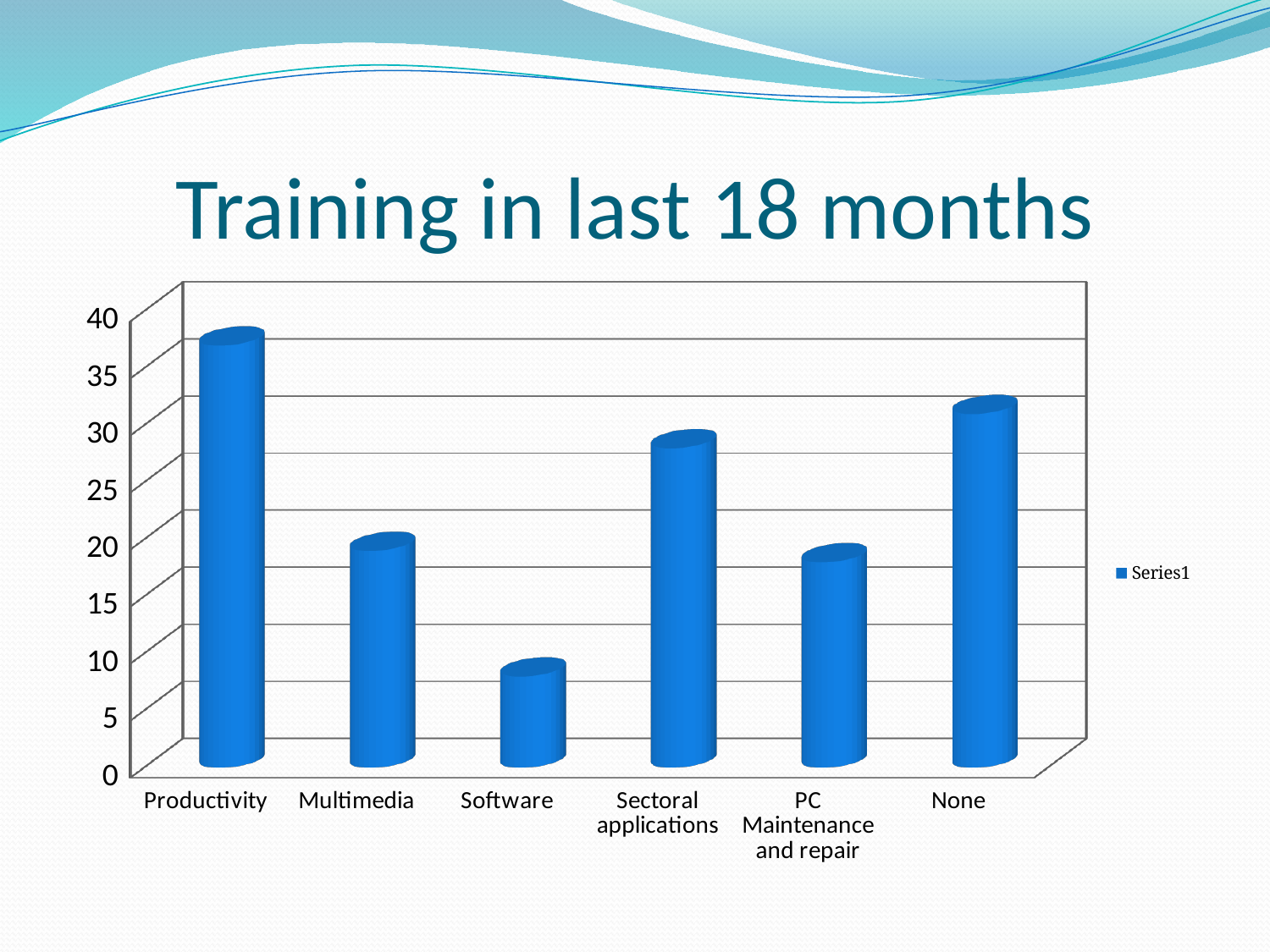
Is the value for Sectoral applications greater or less than 25? greater How many series does the legend list? 1 Which category has the highest value? Productivity Which is larger, the value for Multimedia or the value for Software? Multimedia What is the title of the chart? Training in last 18 months Which category has the lowest value? Software Is the value for Productivity greater or less than 35? greater How many categories are shown on the x axis? 6 Is the value for Software greater or less than 10? less What kind of chart is shown on the slide? bar chart Which is larger, the value for None or the value for Sectoral applications? None